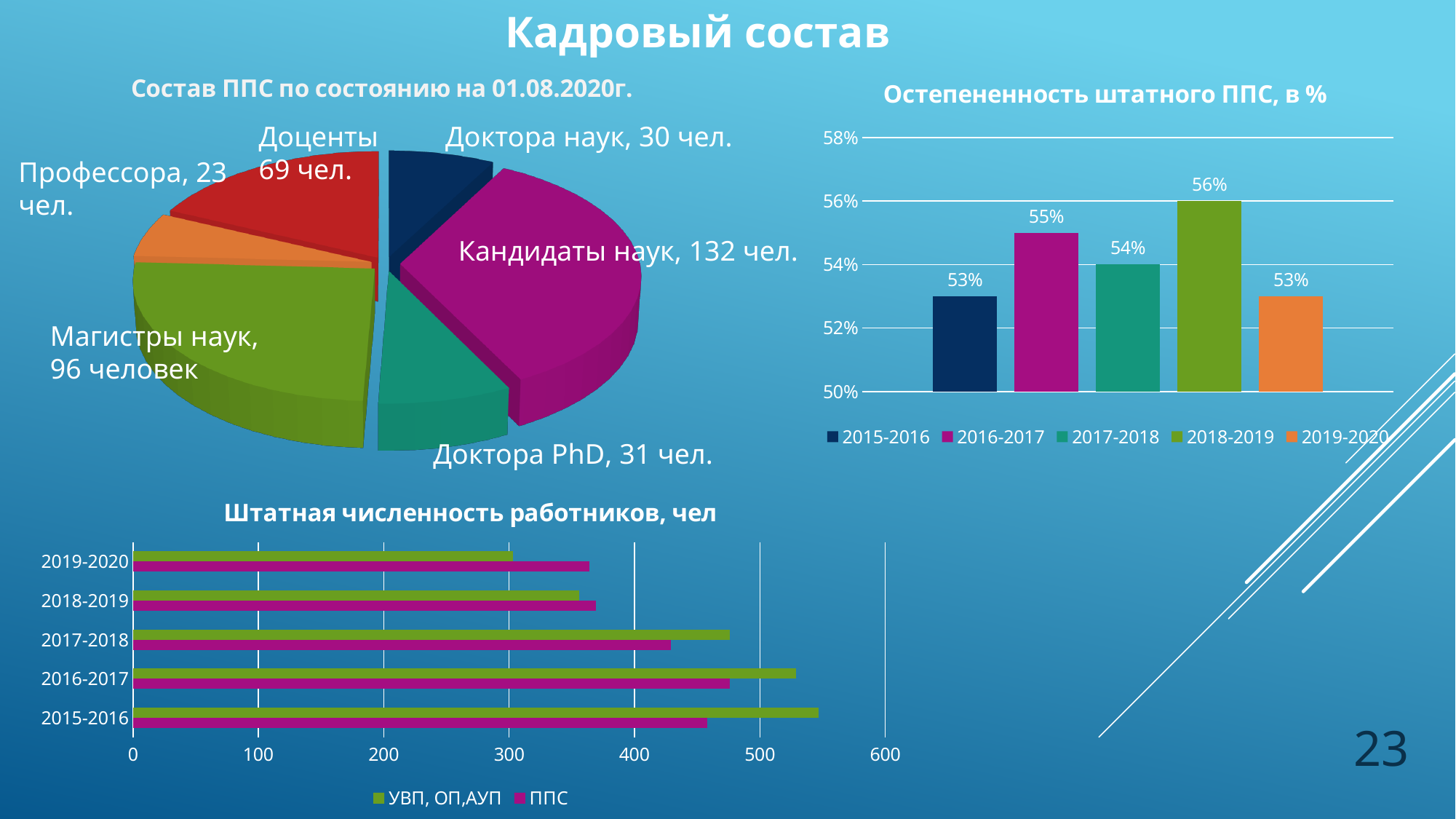
In the pie chart 'Состав ППС по состоянию на 01.08.2020г.', how many categories are shown? 6 What kind of chart is 'Штатная численность работников, чел'? Bar chart In the chart 'Остепененность штатного ППС, в %', which year has the highest value? 2018-2019 In the chart 'Остепененность штатного ППС, в %', what is the difference between the values for 2018-2019 and 2019-2020? 3% In the chart 'Остепененность штатного ППС, в %', how many entries does the legend list? 5 In the pie chart 'Состав ППС по состоянию на 01.08.2020г.', how many people are Кандидаты наук? 132 чел. In the chart 'Штатная численность работников, чел', which is larger for 2016-2017: УВП, ОП,АУП or ППС? УВП, ОП,АУП In the chart 'Остепененность штатного ППС, в %', what is the value for 2016-2017? 55% In the pie chart 'Состав ППС по состоянию на 01.08.2020г.', what is the difference between the number of Магистры наук and the number of Доценты? 27 In the chart 'Штатная численность работников, чел', is the value for УВП, ОП,АУП in 2015-2016 greater or less than 500? greater In the pie chart 'Состав ППС по состоянию на 01.08.2020г.', which category has the smallest number of people? Профессора In the chart 'Штатная численность работников, чел', does the value for УВП, ОП,АУП rise or fall from 2015-2016 to 2019-2020? Fall